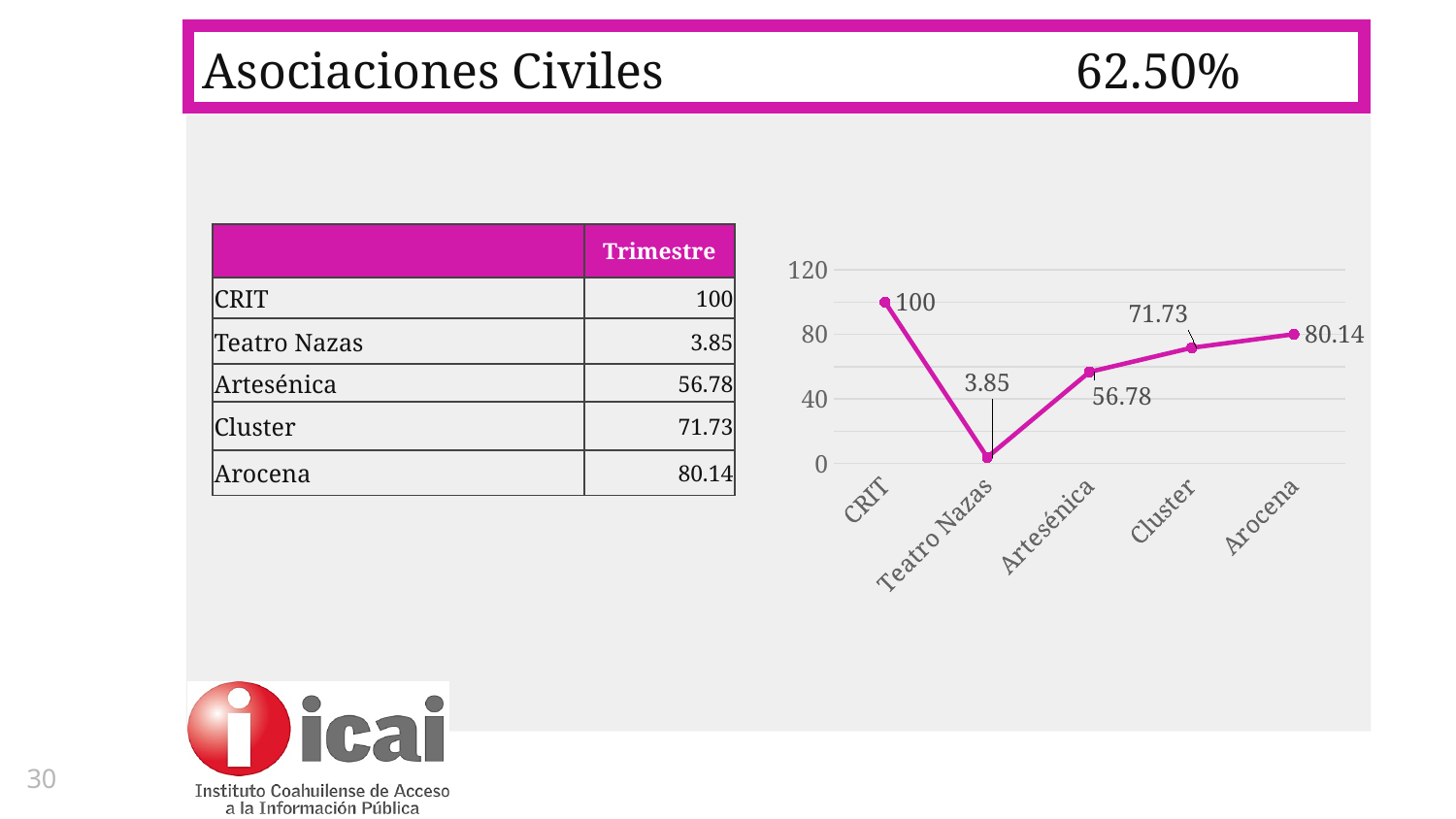
What kind of chart is shown on the slide? line chart What is the value for Arocena in the chart? 80.14 Which category has the highest value in the chart? CRIT How many categories are plotted on the x axis of the chart? 5 Which is larger, the value for Cluster or the value for Artesénica? Cluster What is the value for Artesénica in the chart? 56.78 Is the value for Cluster greater or less than 40? greater What is the value for CRIT in the chart? 100 What is the value for Teatro Nazas in the chart? 3.85 Which category has the lowest value in the chart? Teatro Nazas What is the difference between the values for Arocena and Cluster? 8.41 Do the values rise or fall from Teatro Nazas to Arocena? rise